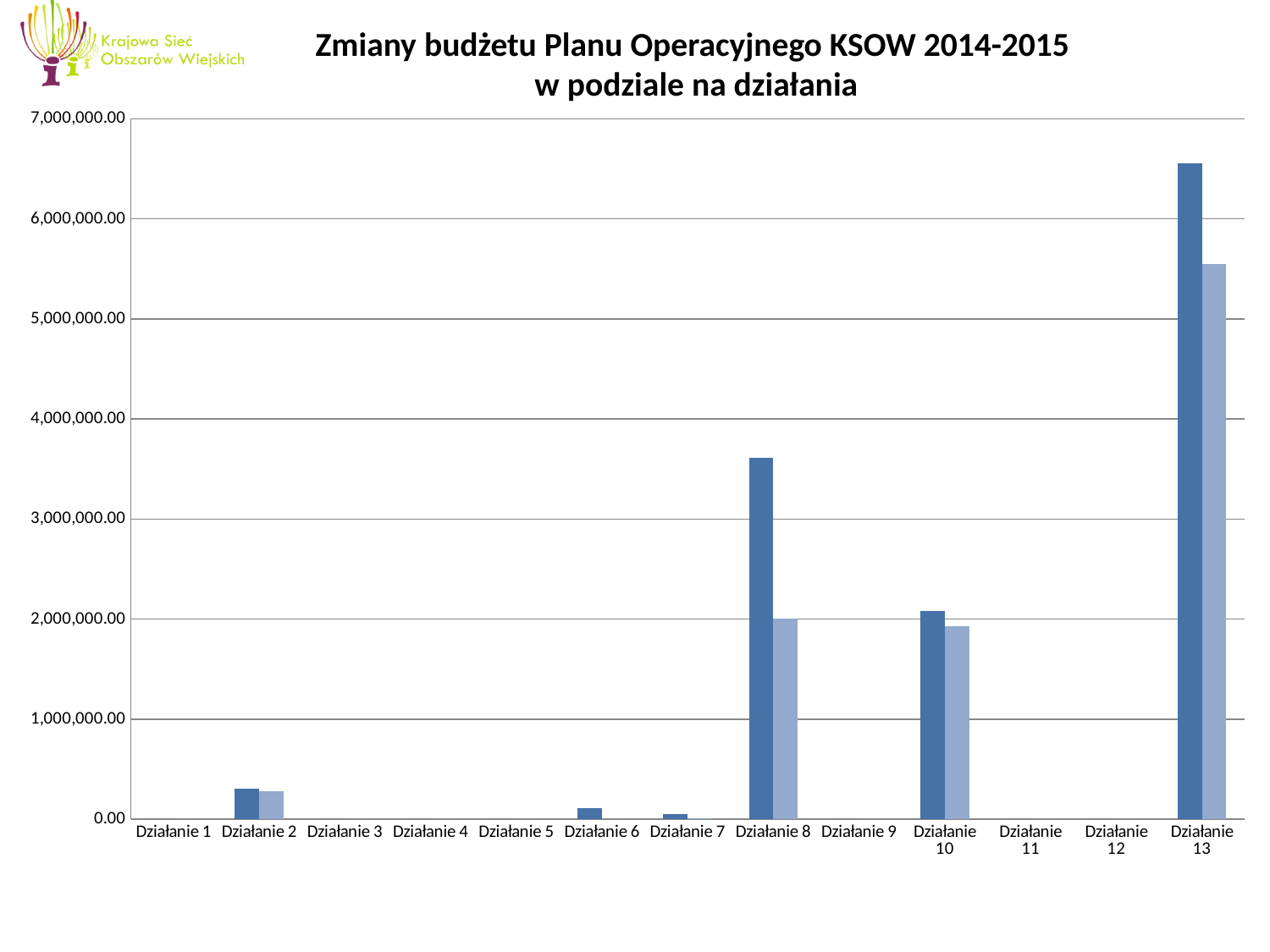
Is the light blue bar for Działanie 13 greater or less than 5,000,000.00? greater How many categories (Działanie) are shown on the x axis? 13 Which has the larger dark blue bar, Działanie 2 or Działanie 6? Działanie 2 For Działanie 13, which bar is taller, the dark blue one or the light blue one? the dark blue one What is the title of the chart? Zmiany budżetu Planu Operacyjnego KSOW 2014-2015 w podziale na działania Which category has the highest bar? Działanie 13 Which has the larger dark blue bar, Działanie 8 or Działanie 10? Działanie 8 What kind of chart is shown on the slide? bar chart Is the dark blue bar for Działanie 2 greater or less than 1,000,000.00? less Is the dark blue bar for Działanie 13 greater or less than 6,000,000.00? greater How many categories have visible bars above zero? 6